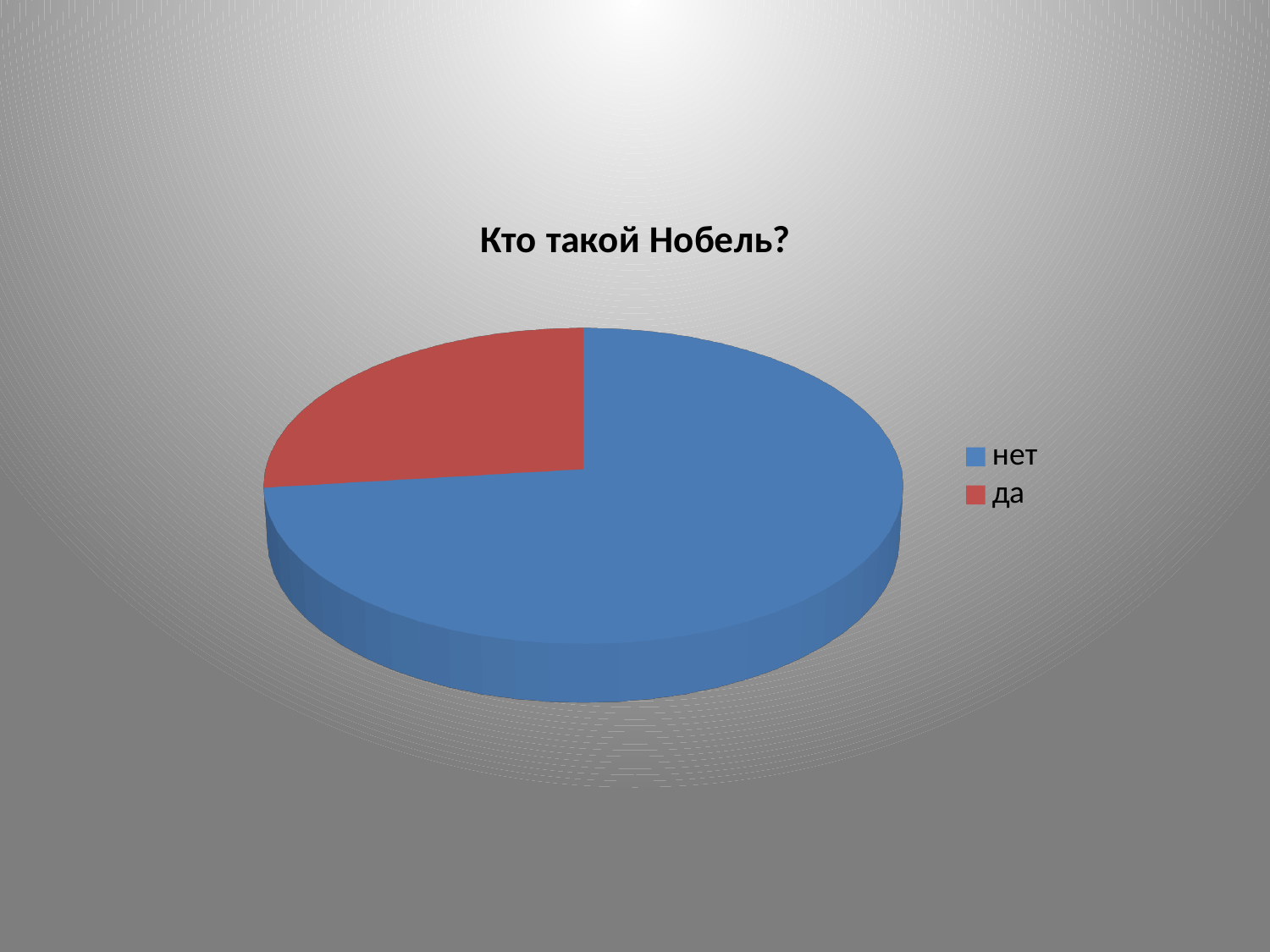
Which category has the largest slice of the pie? нет How many categories does the legend list? 2 What kind of chart is shown on the slide? pie chart Which slice is larger, "нет" or "да"? нет Which category is shown in blue? нет What is the title of the chart? Кто такой Нобель? Which category has the smallest slice of the pie? да What colour is the slice for "да"? red